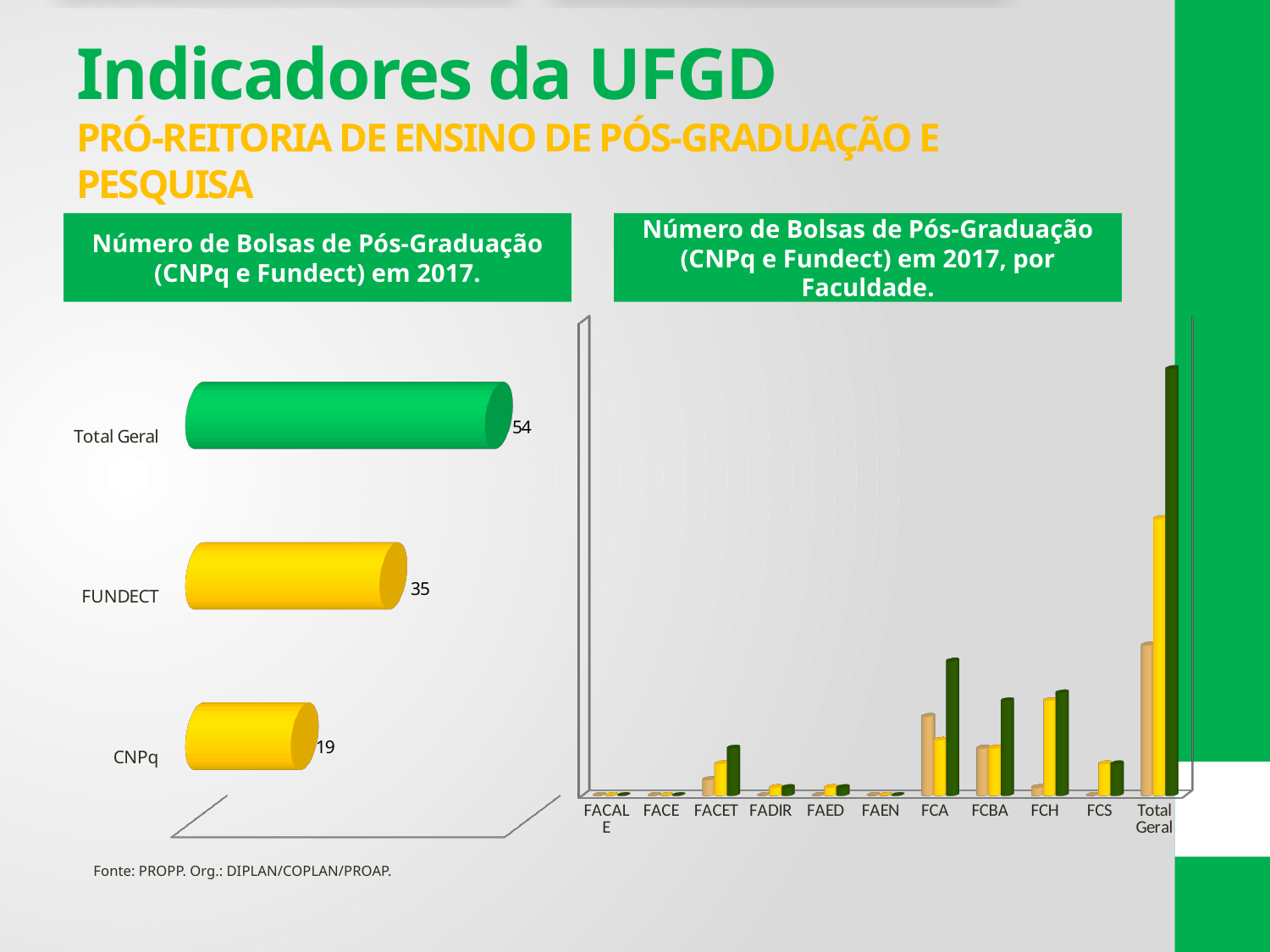
In the right chart, 'Número de Bolsas de Pós-Graduação (CNPq e Fundect) em 2017, por Faculdade.', how many categories are shown on the x axis? 11 In the right chart, 'Número de Bolsas de Pós-Graduação (CNPq e Fundect) em 2017, por Faculdade.', which category has the tallest bars? Total Geral In the left chart, 'Número de Bolsas de Pós-Graduação (CNPq e Fundect) em 2017.', how many categories are shown? 3 What kind of chart is the left chart, 'Número de Bolsas de Pós-Graduação (CNPq e Fundect) em 2017.'? Bar chart In the left chart, 'Número de Bolsas de Pós-Graduação (CNPq e Fundect) em 2017.', what is the value for Total Geral? 54 In the right chart, 'Número de Bolsas de Pós-Graduação (CNPq e Fundect) em 2017, por Faculdade.', which has the taller dark green bar, FCA or FCS? FCA In the left chart, 'Número de Bolsas de Pós-Graduação (CNPq e Fundect) em 2017.', which category has the lowest value? CNPq In the left chart, 'Número de Bolsas de Pós-Graduação (CNPq e Fundect) em 2017.', which is larger, FUNDECT or CNPq? FUNDECT In the left chart, 'Número de Bolsas de Pós-Graduação (CNPq e Fundect) em 2017.', what is the value for FUNDECT? 35 What is the title of the right chart on the slide? Número de Bolsas de Pós-Graduação (CNPq e Fundect) em 2017, por Faculdade. In the left chart, 'Número de Bolsas de Pós-Graduação (CNPq e Fundect) em 2017.', what is the value for CNPq? 19 In the left chart, 'Número de Bolsas de Pós-Graduação (CNPq e Fundect) em 2017.', what is the difference between FUNDECT and CNPq? 16